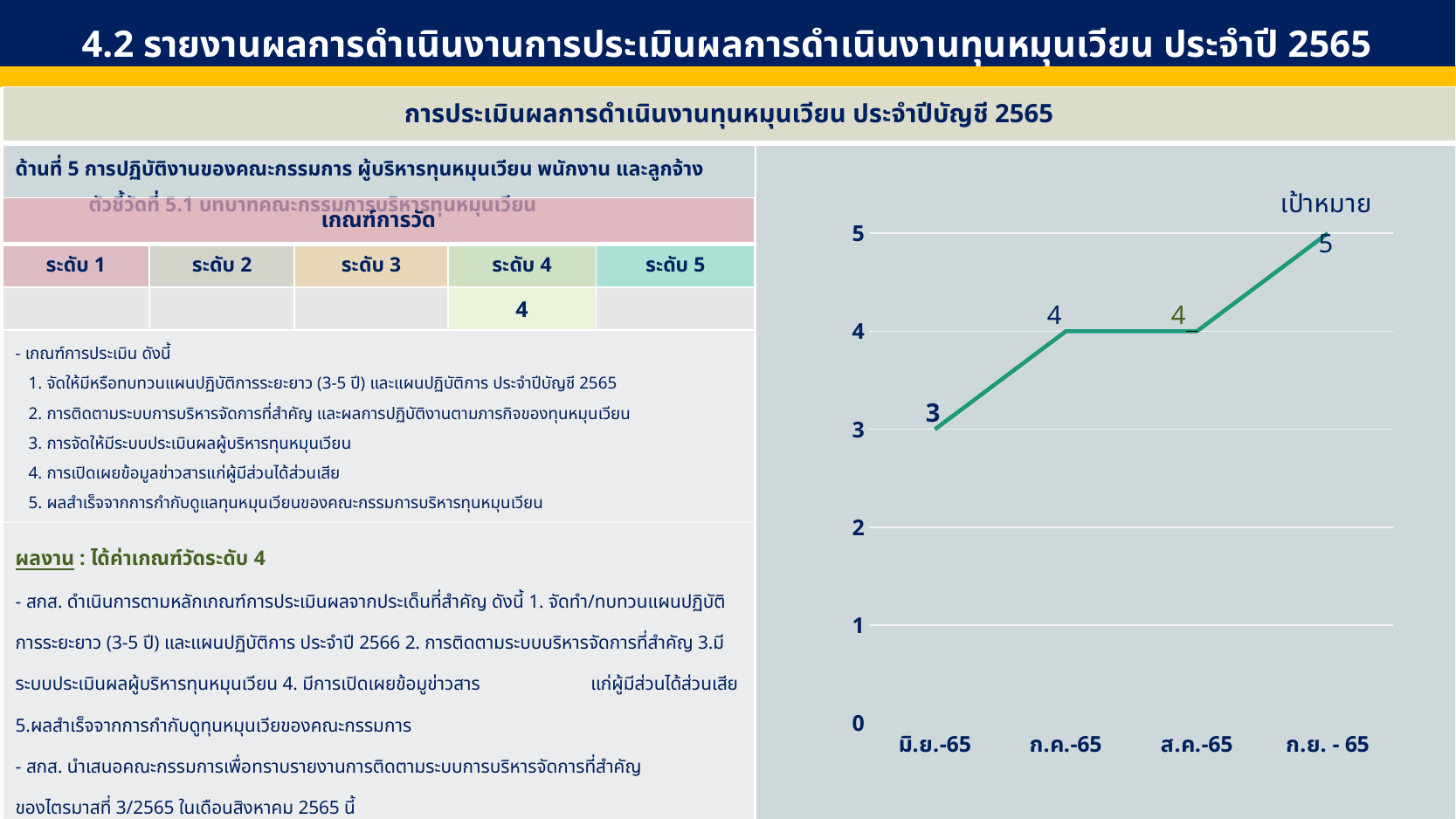
Do the values in the line chart rise or fall from มิ.ย.-65 to ก.ย. - 65? rise Which is larger in the line chart, the value for ก.ค.-65 or the value for มิ.ย.-65? ก.ค.-65 What is the value for ก.ย. - 65 in the line chart? 5 What kind of chart is shown on the right side of the slide? line chart What is the value for ก.ค.-65 in the line chart? 4 What is the difference between the values for ก.ย. - 65 and มิ.ย.-65 in the line chart? 2 How many data points are plotted in the line chart? 4 Which month has the highest value in the line chart? ก.ย. - 65 What is the value for มิ.ย.-65 in the line chart? 3 What label is written near the top right of the line chart above the last point? เป้าหมาย Which month has the lowest value in the line chart? มิ.ย.-65 What is the value for ส.ค.-65 in the line chart? 4